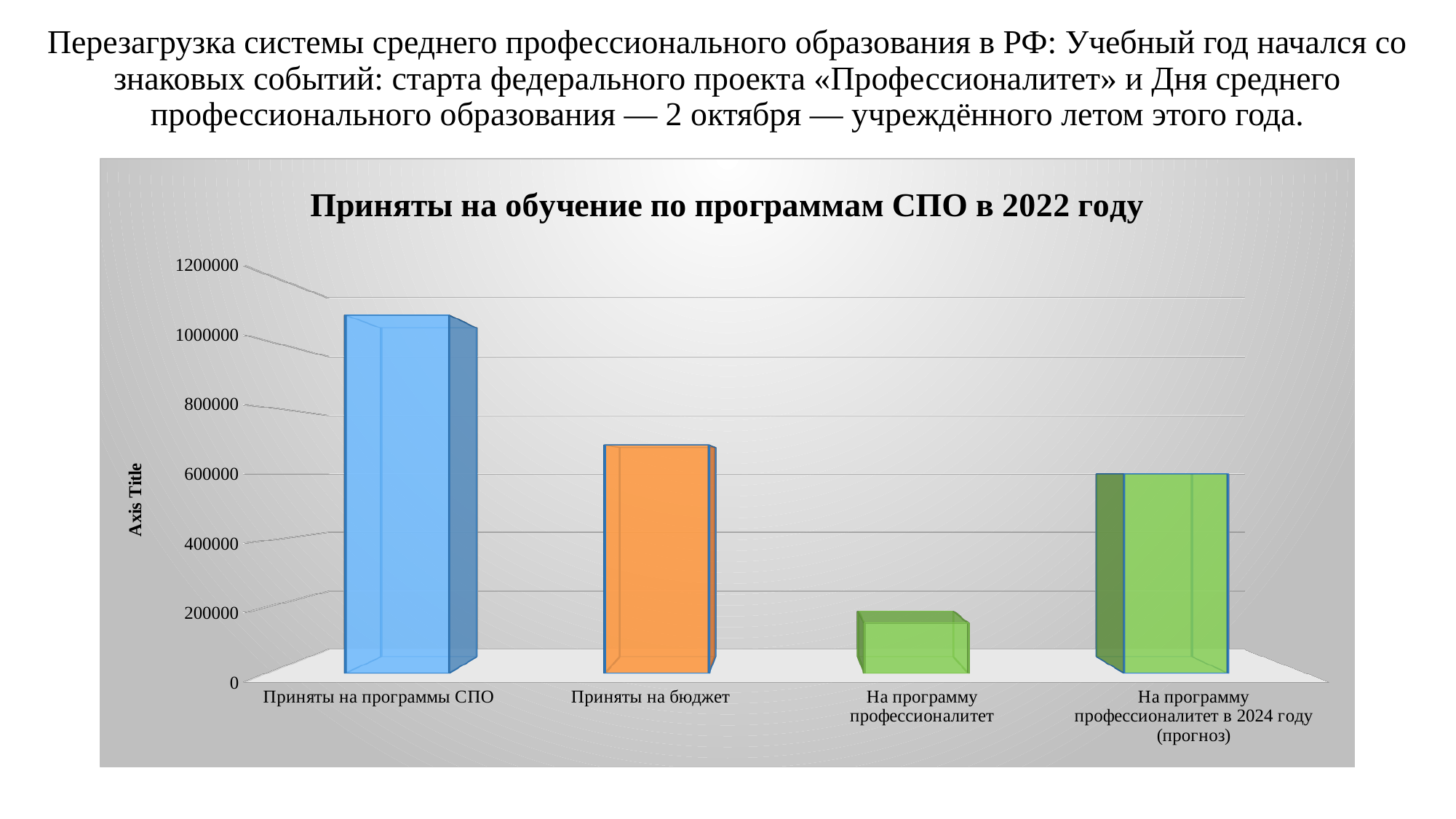
Which is larger: the value for "Приняты на бюджет" or the value for "На программу профессионалитет в 2024 году (прогноз)"? Приняты на бюджет Is the value for "Приняты на программы СПО" greater or less than 1200000? less Is the value for "Приняты на бюджет" greater or less than 600000? greater Is the value for "Приняты на программы СПО" greater or less than 1000000? greater How many categories are plotted in the chart? 4 Which category has the highest value? Приняты на программы СПО Which category has the lowest value? На программу профессионалитет What is the title of the chart? Приняты на обучение по программам СПО в 2022 году What kind of chart is shown on the slide? Bar chart